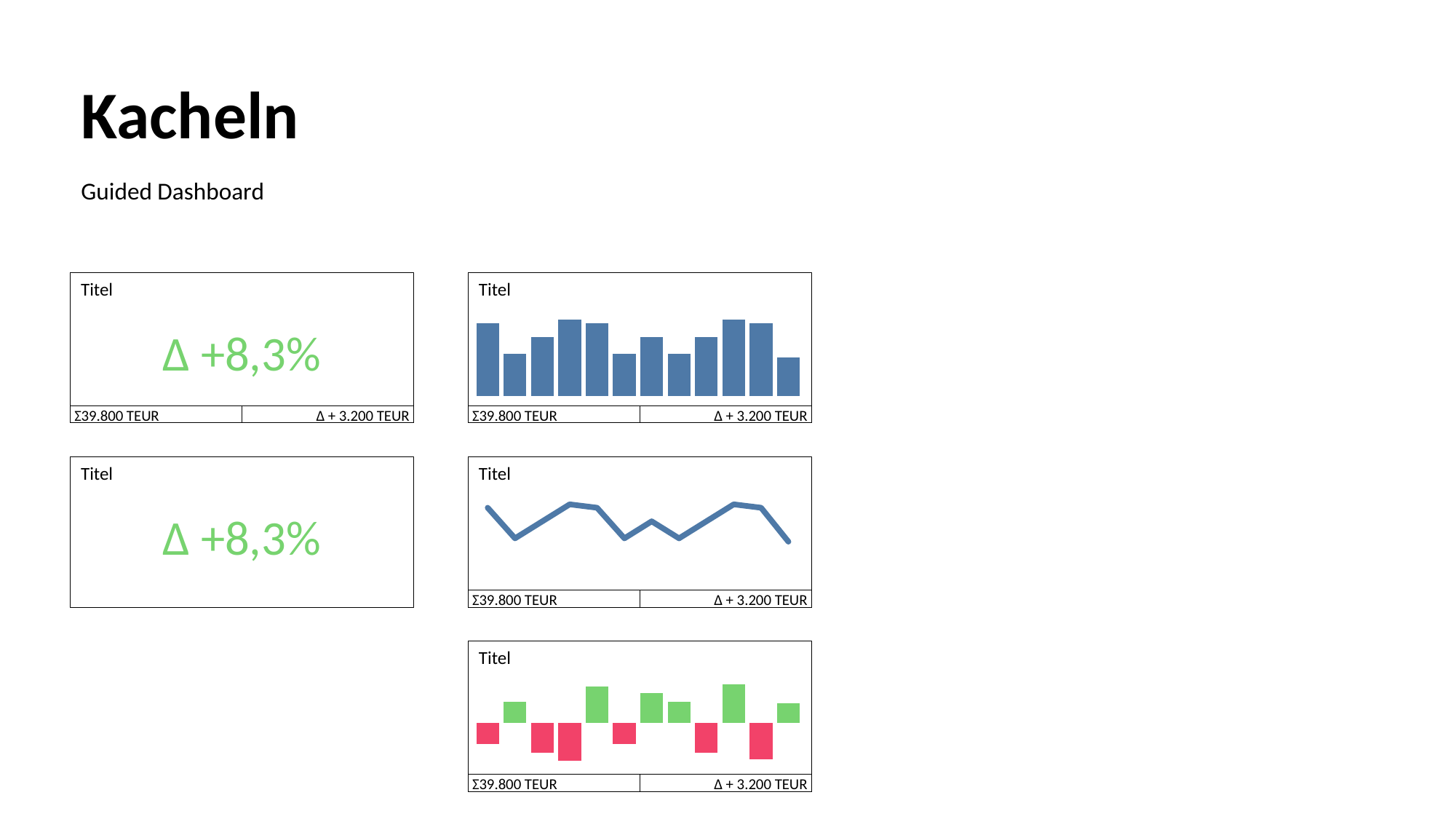
What kind of chart is shown in the top-right tile? bar chart What kind of chart is shown in the bottom-right tile? bar chart How many data points does the line chart in the middle-right tile have? 12 In the top-right bar chart, is the last bar taller or shorter than the first bar? shorter In the bottom-right bar chart, how many bars are red? 6 What kind of chart is shown in the middle-right tile? line chart How many bars does the bar chart in the bottom-right tile have? 12 In the middle-right line chart, is the last point higher or lower than the first point? lower What title is shown on the tile containing the line chart? Titel What colour are the bars in the top-right bar chart? blue